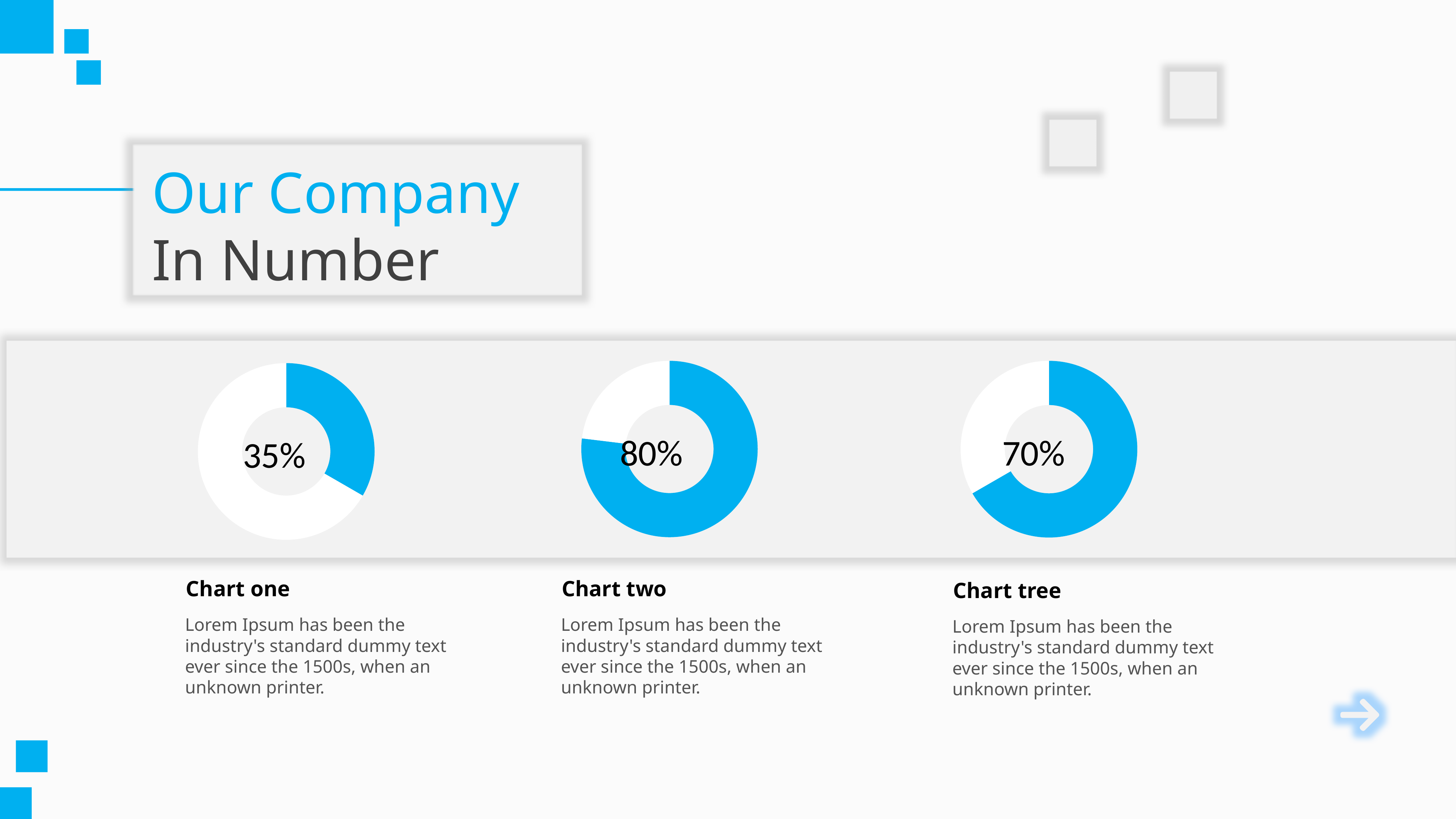
Which shows a larger percentage, Chart one or Chart tree? Chart tree What colour is the filled portion of the rings in the three donut charts? Blue How many donut charts are shown on the slide? 3 Which of the three donut charts shows the highest percentage? Chart two What is the difference between the percentage in Chart two and the percentage in Chart one? 45% Which of the three donut charts shows the lowest percentage? Chart one What is the difference between the percentage in Chart two and the percentage in Chart tree? 10% What kind of chart is used for Chart one, Chart two and Chart tree? Donut chart What percentage is shown in the centre of the donut chart labelled "Chart two"? 80% What percentage is shown in the centre of the donut chart labelled "Chart one"? 35% What percentage is shown in the centre of the donut chart labelled "Chart tree"? 70%